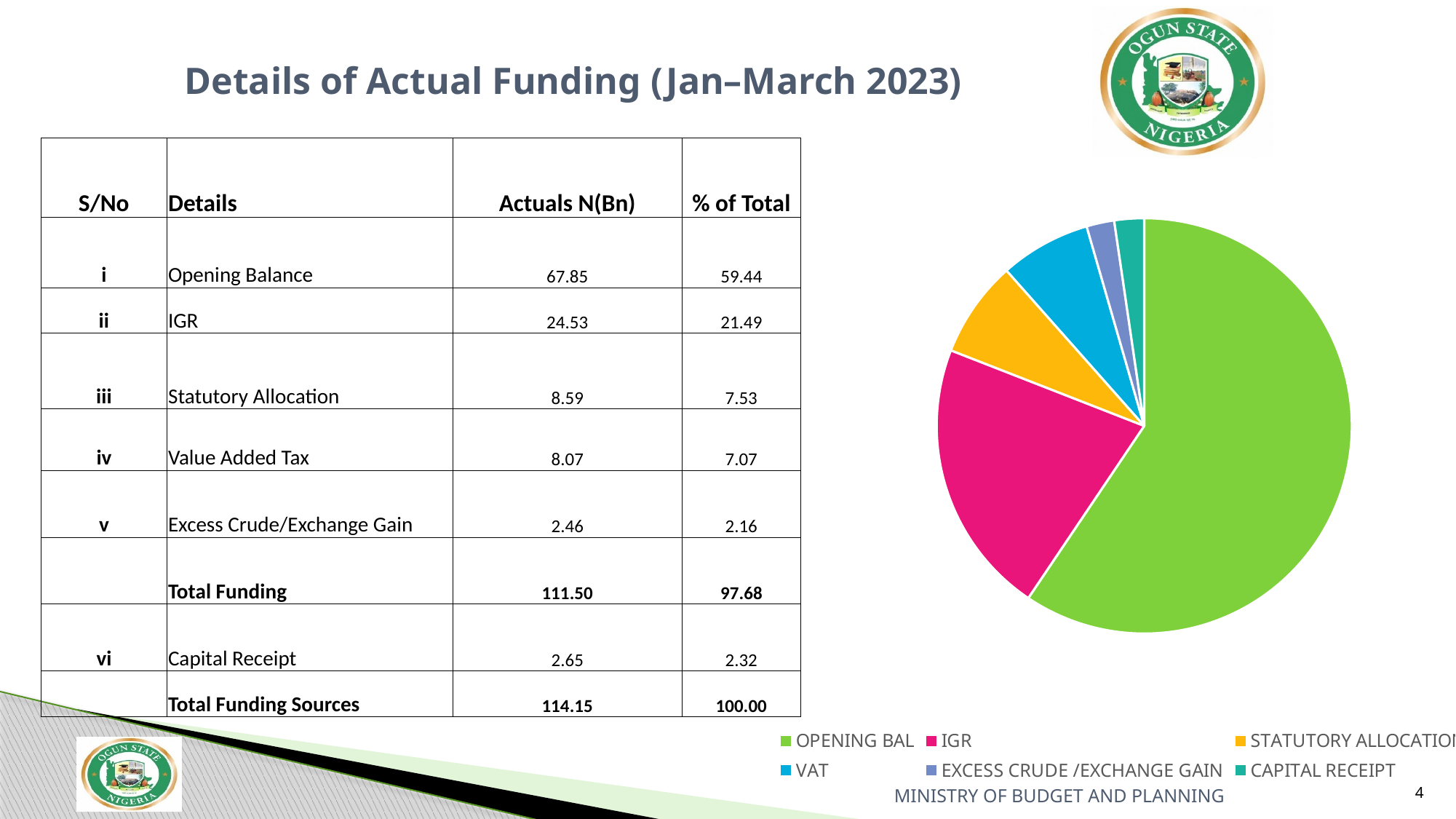
How many slices does the pie chart have? 6 Which category has the smallest slice in the pie chart? EXCESS CRUDE /EXCHANGE GAIN According to the table on the slide, what is the Actuals N(Bn) value for Value Added Tax? 8.07 What kind of chart is shown on the slide? pie chart According to the table on the slide, what share of the total does the Opening Balance slice represent? 59.44 How many entries does the pie chart's legend list? 6 According to the table on the slide, what share of the total does the IGR slice represent? 21.49 Which category has the largest slice in the pie chart? OPENING BAL What colour is the IGR slice in the pie chart? pink Which slice is larger in the pie chart, STATUTORY ALLOCATION or CAPITAL RECEIPT? STATUTORY ALLOCATION What colour is the OPENING BAL slice in the pie chart? green Which slice is larger in the pie chart, IGR or VAT? IGR